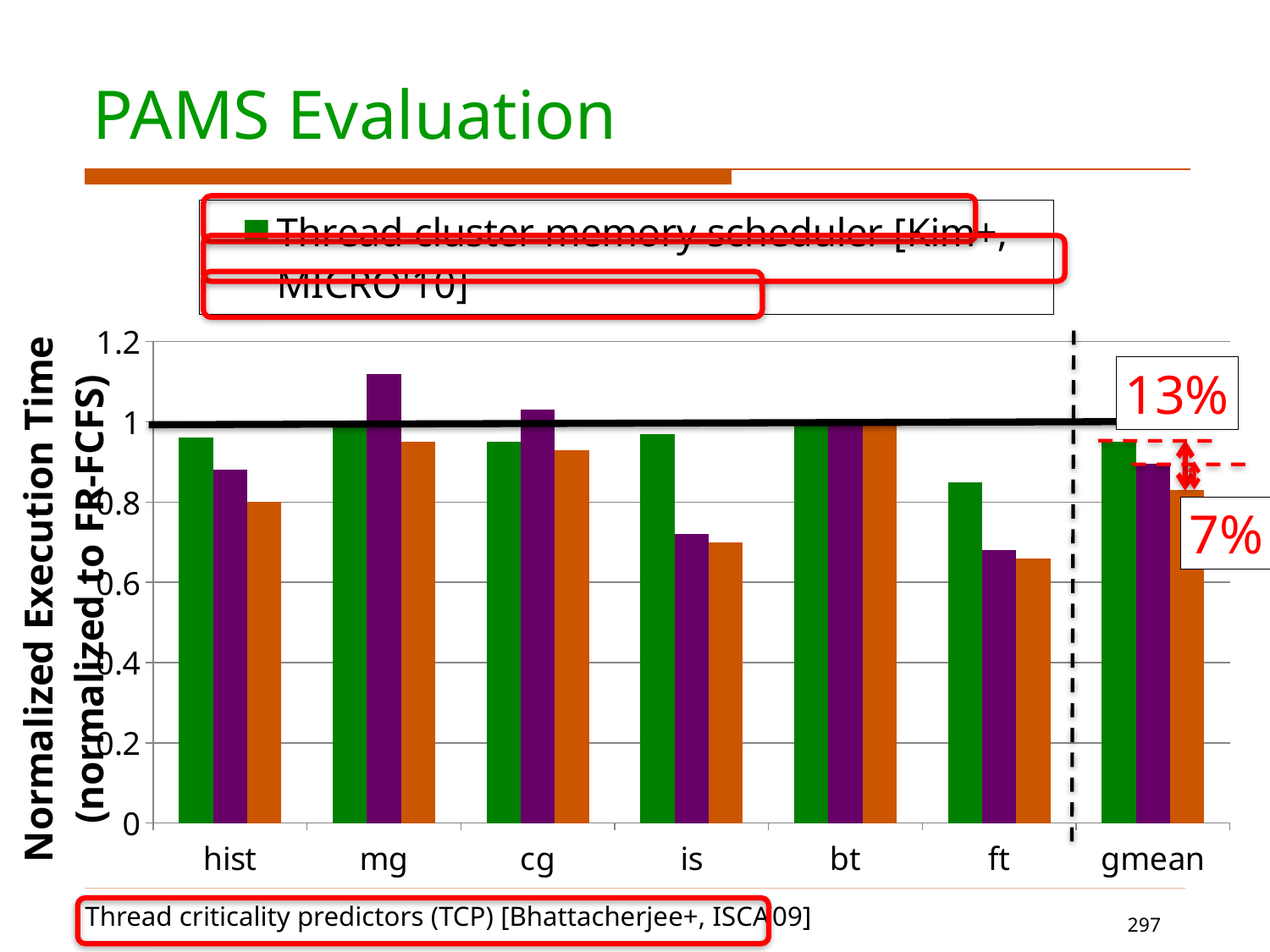
Is the green bar for hist greater or less than 0.8? greater Which category has the tallest purple bar? mg Is the purple bar for is greater or less than 0.8? less For ft, which is larger: the green bar or the orange bar? green bar How many categories are shown along the x axis of the chart? 7 What kind of chart is shown on the slide? bar chart Is the orange bar for ft greater or less than 0.8? less What is the label of the y axis of the chart? Normalized Execution Time (normalized to FR-FCFS) Which category has the shortest green bar? ft How many series (bar colours) are plotted for each category in the chart? 3 For mg, which is larger: the purple bar or the orange bar? purple bar